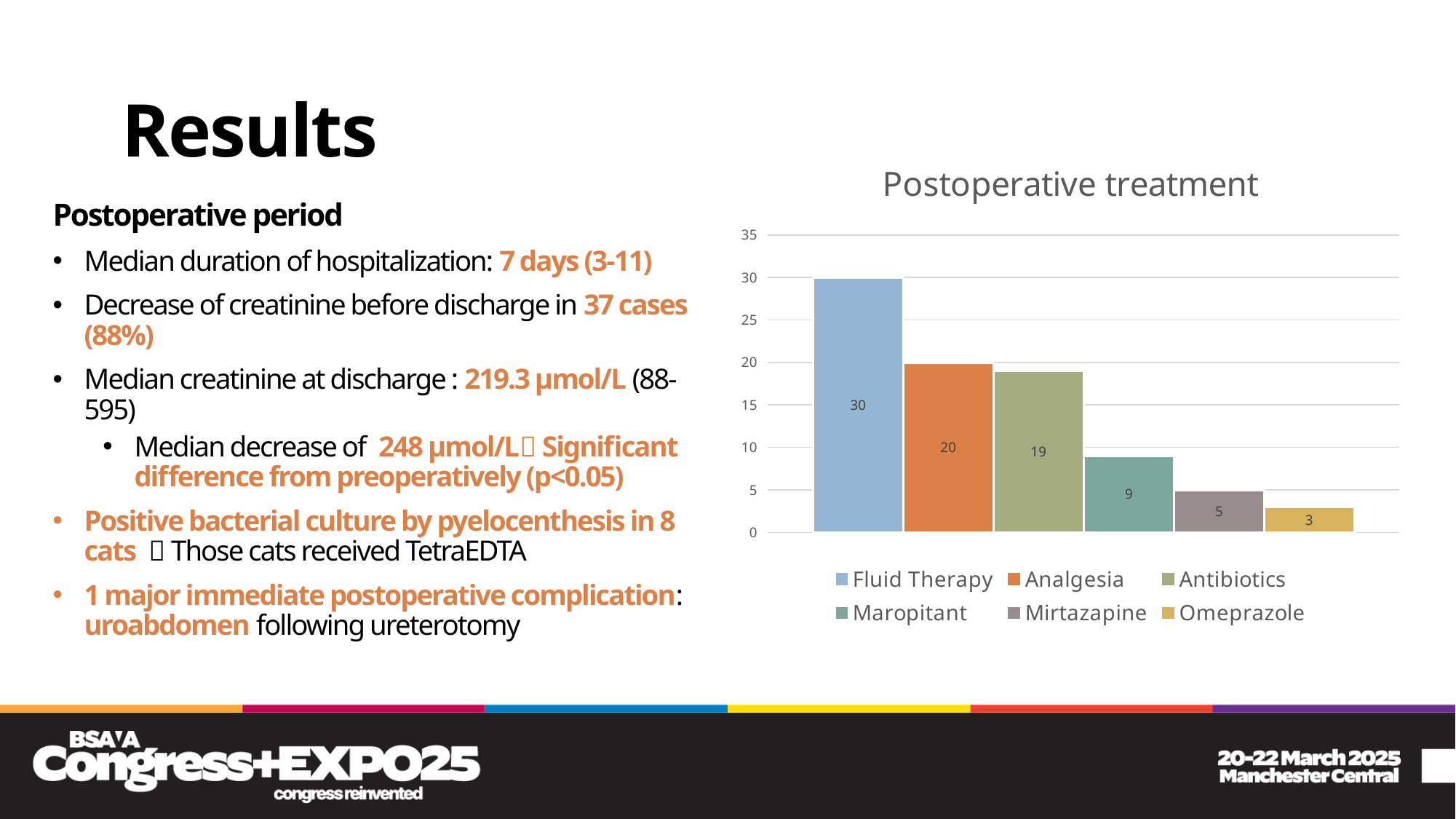
What kind of chart is the Postoperative treatment chart? bar chart What is the title of the chart on the slide? Postoperative treatment What is the difference between the values for Maropitant and Mirtazapine? 4 Which treatment has the highest value in the Postoperative treatment chart? Fluid Therapy Is the value for Mirtazapine greater or less than 10? less What is the value for Antibiotics in the Postoperative treatment chart? 19 Which is larger, the value for Analgesia or the value for Maropitant? Analgesia What is the value for Omeprazole in the Postoperative treatment chart? 3 Which treatment has the lowest value in the Postoperative treatment chart? Omeprazole How many treatments are shown in the Postoperative treatment chart? 6 What is the difference between the values for Fluid Therapy and Analgesia? 10 What is the value for Fluid Therapy in the Postoperative treatment chart? 30